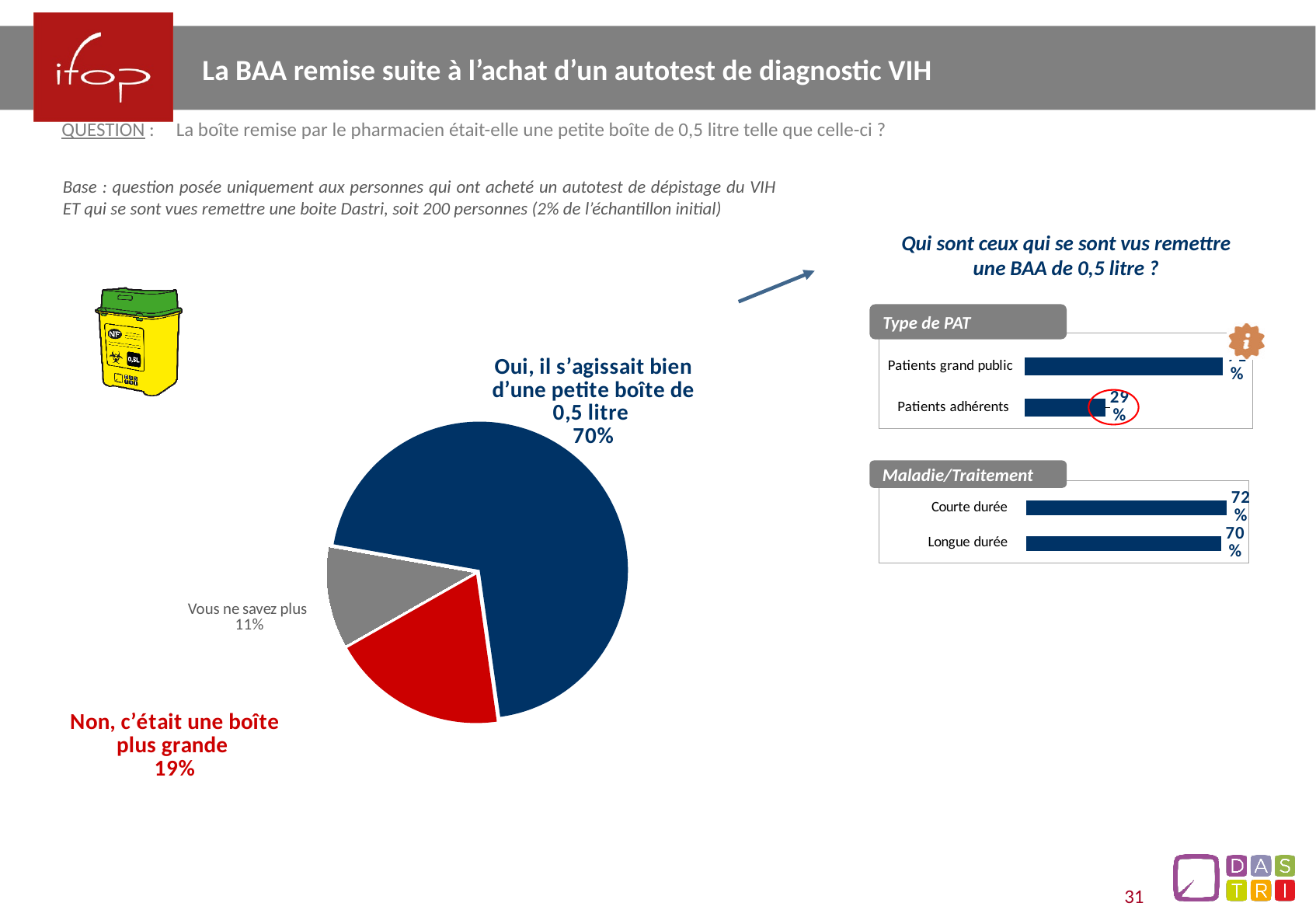
How many slices does the pie chart have? 3 In the "Type de PAT" chart, what is the value for Patients adhérents? 29% In the pie chart, what percentage answered "Non, c'était une boîte plus grande"? 19% In the "Type de PAT" chart, which category has the larger value, Patients grand public or Patients adhérents? Patients grand public What type of chart is the large chart on the left of the slide? Pie chart In the pie chart, what share of respondents answered "Oui, il s'agissait bien d'une petite boîte de 0,5 litre"? 70% In the pie chart, which answer has the smallest share? Vous ne savez plus In the "Maladie/Traitement" chart, what is the value for Courte durée? 72% In the pie chart, what percentage answered "Vous ne savez plus"? 11% In the pie chart, what is the difference in percentage points between the "Oui" slice and the "Non" slice? 51 In the "Maladie/Traitement" chart, what is the difference in percentage points between Courte durée and Longue durée? 2 In the pie chart, which answer has the largest share? Oui, il s'agissait bien d'une petite boîte de 0,5 litre